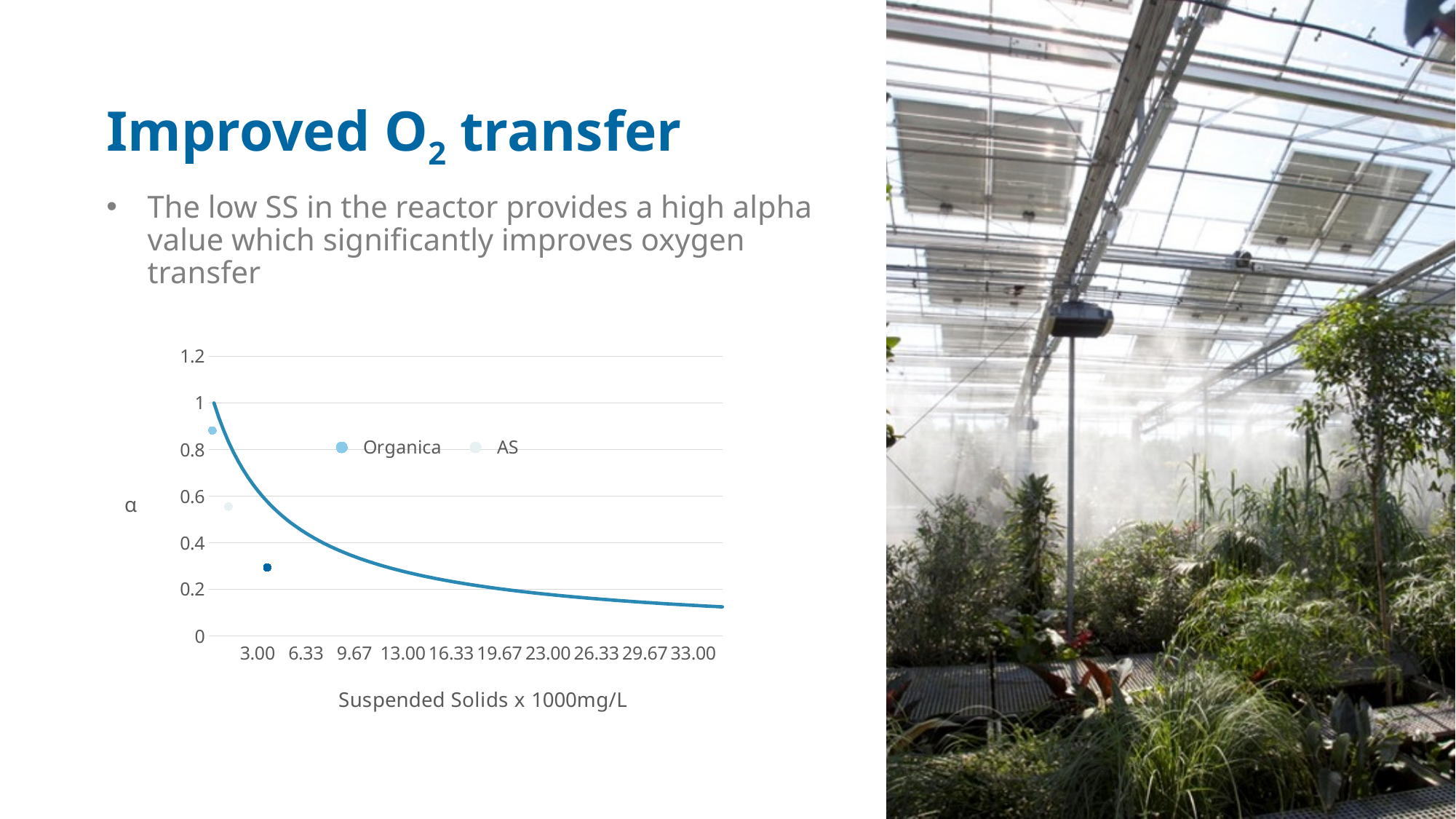
What is the highest value labelled on the y axis of the chart? 1.2 How many series does the chart legend list? 2 What is the x-axis title of the chart? Suspended Solids x 1000mg/L Does the curve in the chart rise or fall as Suspended Solids increases along the x axis? fall What are the two series named in the chart legend? Organica and AS Is the α value of the Organica point greater or less than 0.8? greater Is the α value of the AS point greater or less than 0.6? less What kind of chart is shown on the slide? line chart Is the α value of the curve at 9.67 greater or less than 0.4? less How many tick labels are shown on the x axis of the chart? 10 Which plotted point has the higher α value, Organica or AS? Organica